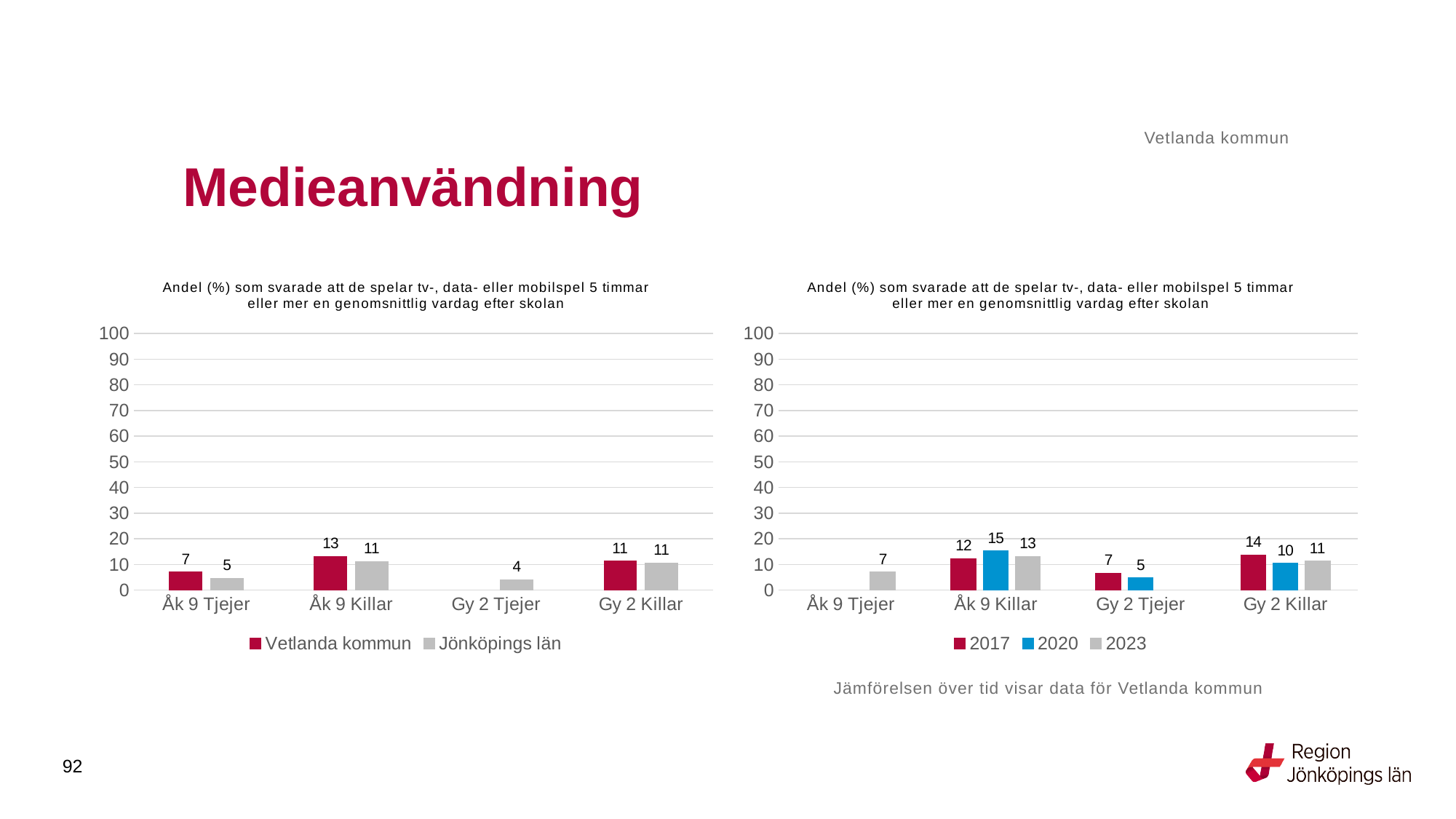
In the right chart, what is the value for 2020 for Åk 9 Killar? 15 In the left chart, what is the difference between Vetlanda kommun and Jönköpings län for Åk 9 Tjejer? 2 In the right chart, which year has the lowest value for Gy 2 Killar? 2020 In the right chart, what is the difference between 2017 and 2020 for Gy 2 Tjejer? 2 In the left chart, what kind of chart is shown? Bar chart In the right chart, is the value for 2023 for Åk 9 Tjejer greater or less than 10? less In the left chart, what is the value for Jönköpings län for Gy 2 Tjejer? 4 In the left chart, which category has the highest value for Vetlanda kommun? Åk 9 Killar In the left chart, what is the value for Vetlanda kommun for Åk 9 Killar? 13 In the right chart, what is the value for 2017 for Gy 2 Killar? 14 In the right chart, how many series does the legend list? 3 In the left chart, how many series does the legend list? 2